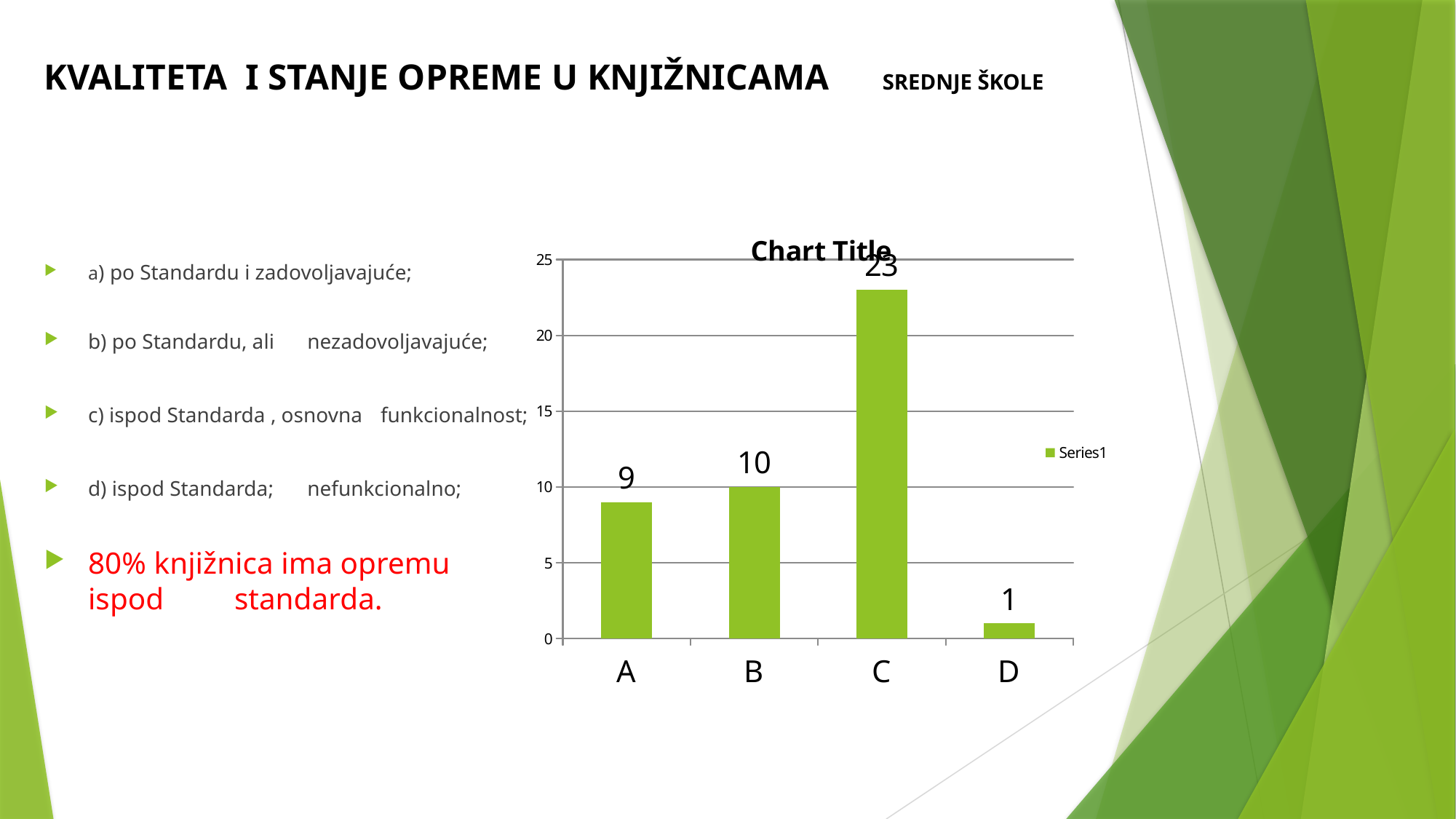
Which category has the highest value? C What is the value for category A? 9 Which category has the lowest value? D What is the title of the chart? Chart Title What kind of chart is shown? bar chart Is the value for C greater or less than 20? greater Which is larger, the value for A or the value for B? B How many series does the legend list? 1 What is the value for category D? 1 What is the difference between the values for C and B? 13 How many categories are shown on the x axis? 4 What is the value for category C? 23